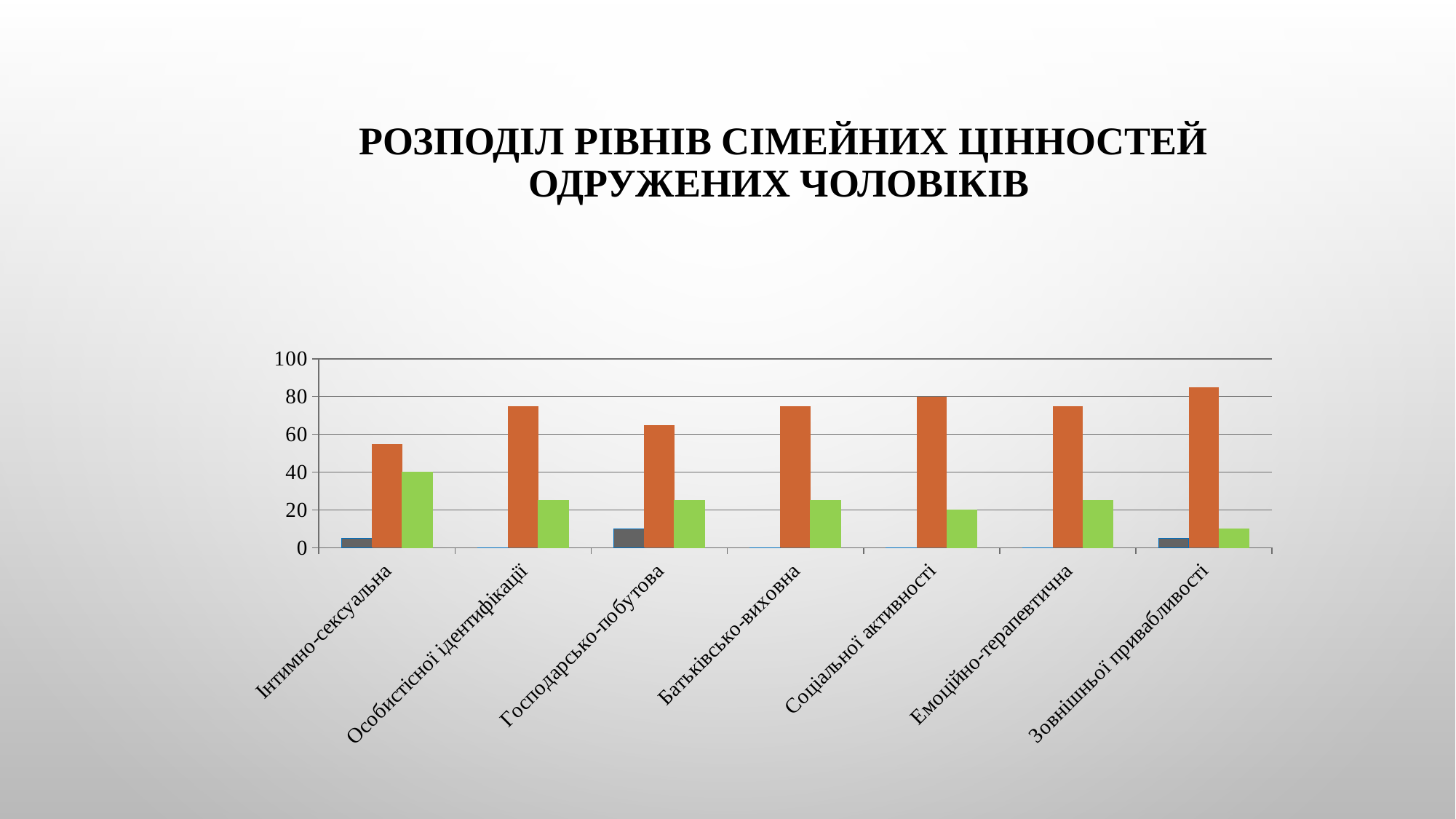
Which category has the highest green bar? Інтимно-сексуальна Which category has the lowest orange bar? Інтимно-сексуальна Is the orange bar for Зовнішньої привабливості greater or less than 80? greater Which category has the highest orange bar? Зовнішньої привабливості Is the orange bar for Особистісної ідентифікації greater or less than 60? greater Is the orange bar for Інтимно-сексуальна greater or less than 60? less For Господарсько-побутова, which bar is taller, the orange one or the green one? orange How many categories are shown on the x axis of the chart? 7 Which category has the lowest green bar? Зовнішньої привабливості What kind of chart is shown on the slide? bar chart What is the title of the slide? РОЗПОДІЛ РІВНІВ СІМЕЙНИХ ЦІННОСТЕЙ ОДРУЖЕНИХ ЧОЛОВІКІВ